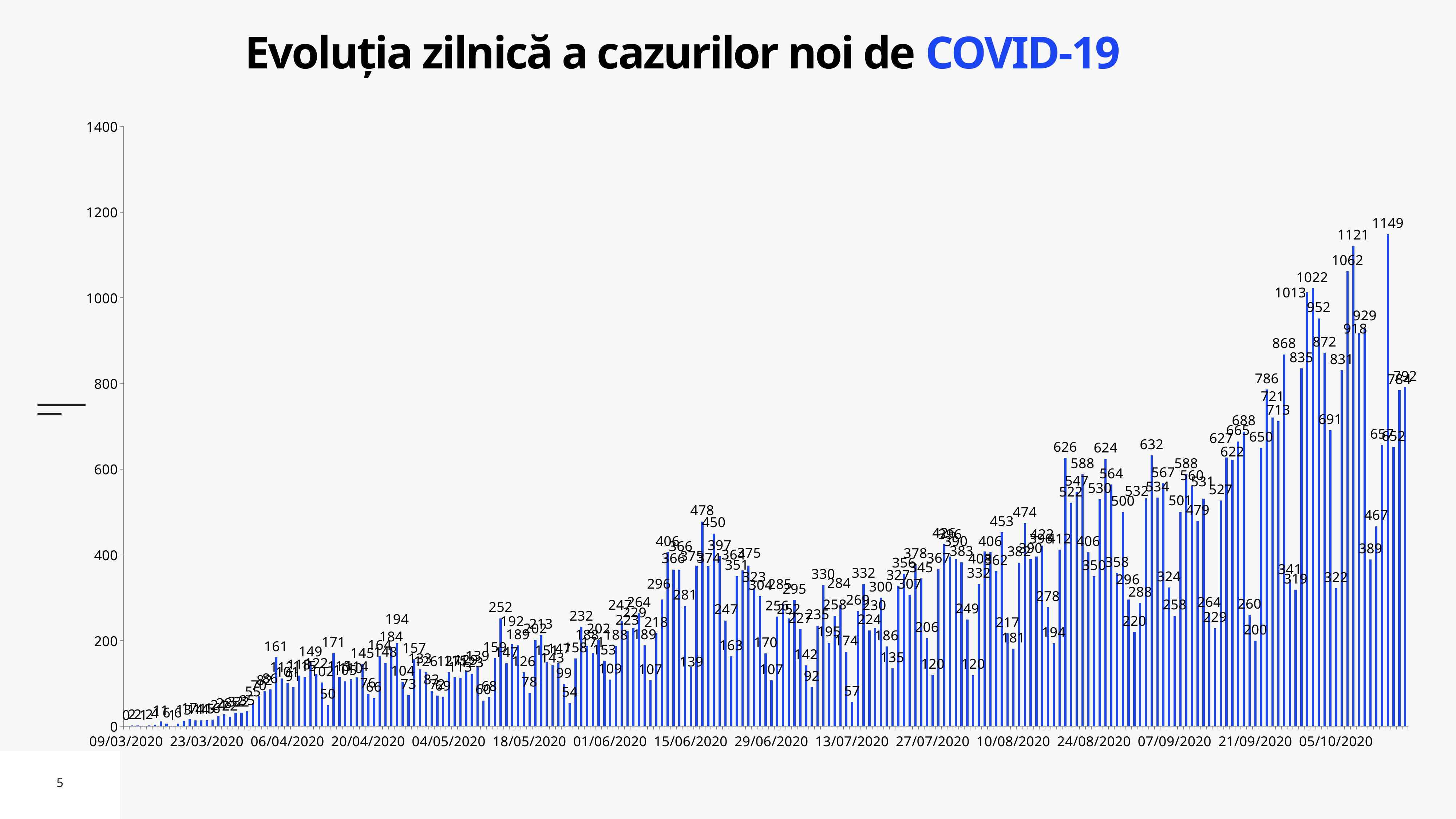
What is the title of the chart? Evoluția zilnică a cazurilor noi de COVID-19 What is the second highest value labelled in the chart? 1121 Which is larger, the bar labelled 1149 or the bar labelled 1121? 1149 What is the maximum value shown on the vertical axis? 1400 What is the difference between the bar labelled 1149 and the bar labelled 1121? 28 Overall, do the daily values rise or fall from March 2020 to October 2020? rise What is the highest daily value shown in the chart? 1149 What is the lowest value labelled in the chart? 0 Is the highest bar in the chart greater or less than 1000? greater What kind of chart is shown on the slide? bar chart What is the difference between the bar labelled 1149 and the bar labelled 1062? 87 Is the highest bar in the chart greater or less than 1200? less